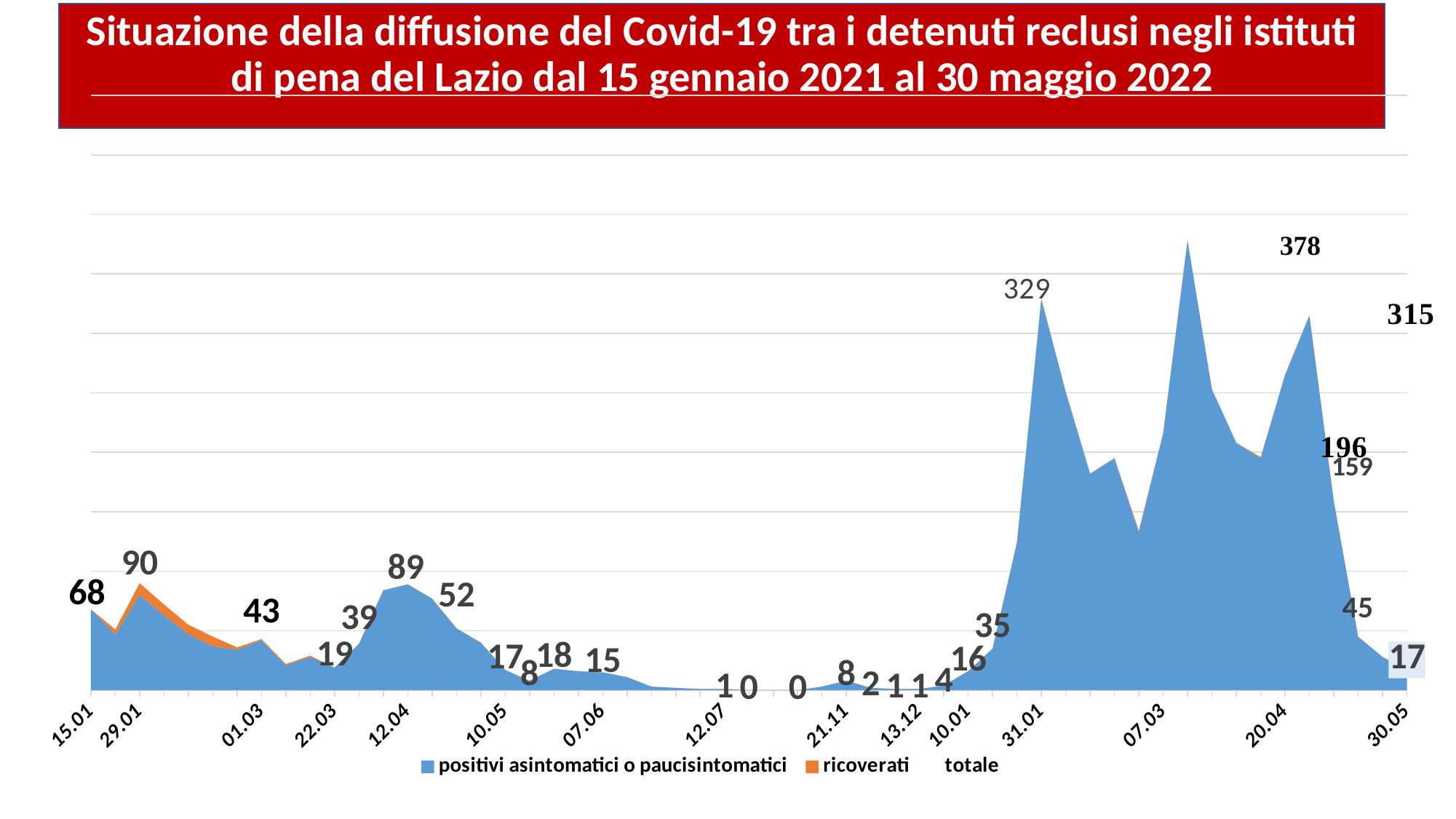
What is the labelled value at 15.01, the first date on the x axis? 68 What is the lowest data label shown on the chart? 0 Which date has the larger labelled value, 12.04 or 12.07? 12.04 Which series is shown in orange in the legend? ricoverati What is the labelled value at 30.05, the last date on the x axis? 17 What is the labelled value at 12.04? 89 How many series does the legend list? 3 What is the labelled value at 29.01? 90 What is the difference between the labelled values at 29.01 and 15.01? 22 What is the labelled value at 31.01? 329 What is the highest data label shown on the chart? 378 What kind of chart is shown on the slide? area chart